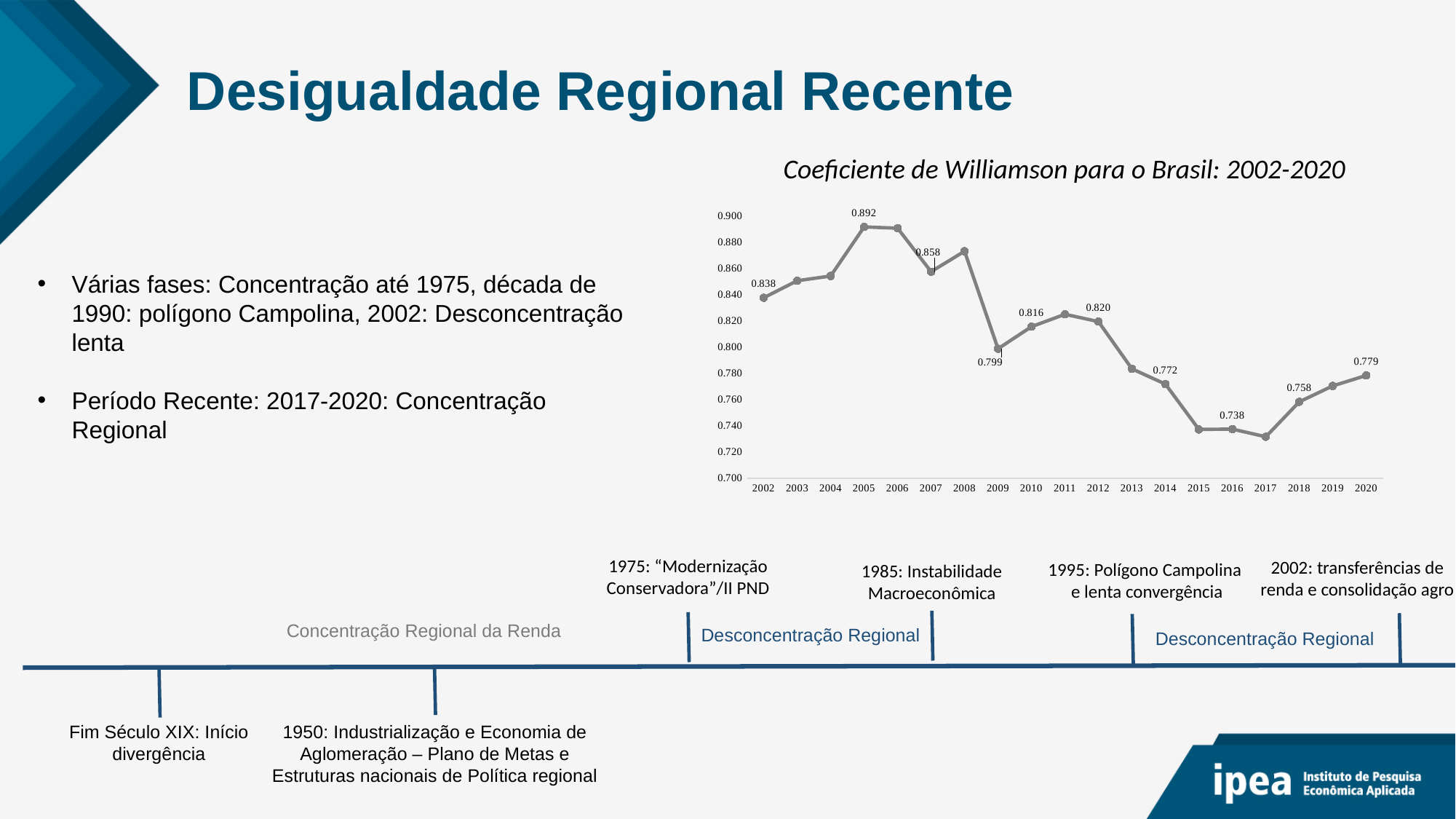
Which year has the larger value, 2010 or 2012? 2012 What is the highest value printed as a data label on the chart, and in which year does it occur? 0.892 in 2005 What is the difference between the values for 2005 and 2002? 0.054 What is the value of the Williamson coefficient for 2020? 0.779 Is the value for 2008 greater or less than 0.860? greater What is the value of the Williamson coefficient for 2016? 0.738 What is the difference between the values for 2012 and 2016? 0.082 Is the value for 2013 greater or less than 0.800? less What is the value of the Williamson coefficient for 2002? 0.838 How many years are plotted on the x axis of the chart? 19 What kind of chart is shown on the slide? line chart Do the values rise or fall from 2017 to 2020? rise